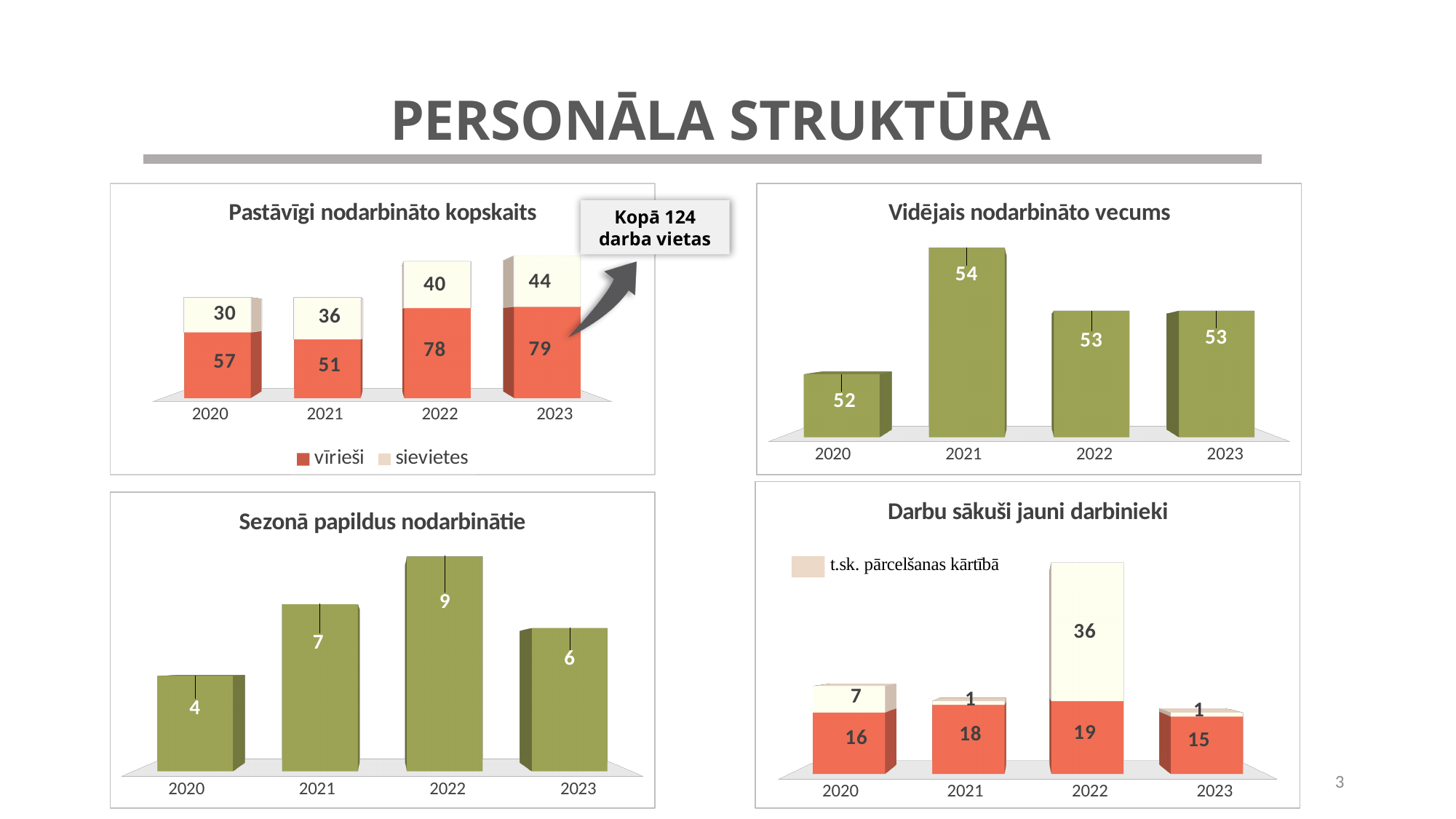
In the chart titled "Pastāvīgi nodarbināto kopskaits", what is the difference between the vīrieši values for 2023 and 2020? 22 What kind of chart is "Vidējais nodarbināto vecums"? bar chart In the chart titled "Pastāvīgi nodarbināto kopskaits", how many series does the legend list? 2 In the chart titled "Darbu sākuši jauni darbinieki", what is the value for t.sk. pārcelšanas kārtībā in 2022? 36 In the chart titled "Vidējais nodarbināto vecums", which year has the highest value? 2021 In the chart titled "Pastāvīgi nodarbināto kopskaits", what is the value for vīrieši in 2022? 78 In the chart titled "Sezonā papildus nodarbinātie", what is the difference between the values for 2022 and 2023? 3 In the chart titled "Sezonā papildus nodarbinātie", which year has the lowest value? 2020 In the chart titled "Vidējais nodarbināto vecums", what is the value for 2020? 52 In the chart titled "Pastāvīgi nodarbināto kopskaits", what is the total of the stacked bar for 2022? 118 In the chart titled "Pastāvīgi nodarbināto kopskaits", what is the value for sievietes in 2021? 36 In the chart titled "Sezonā papildus nodarbinātie", how many years are shown on the x axis? 4